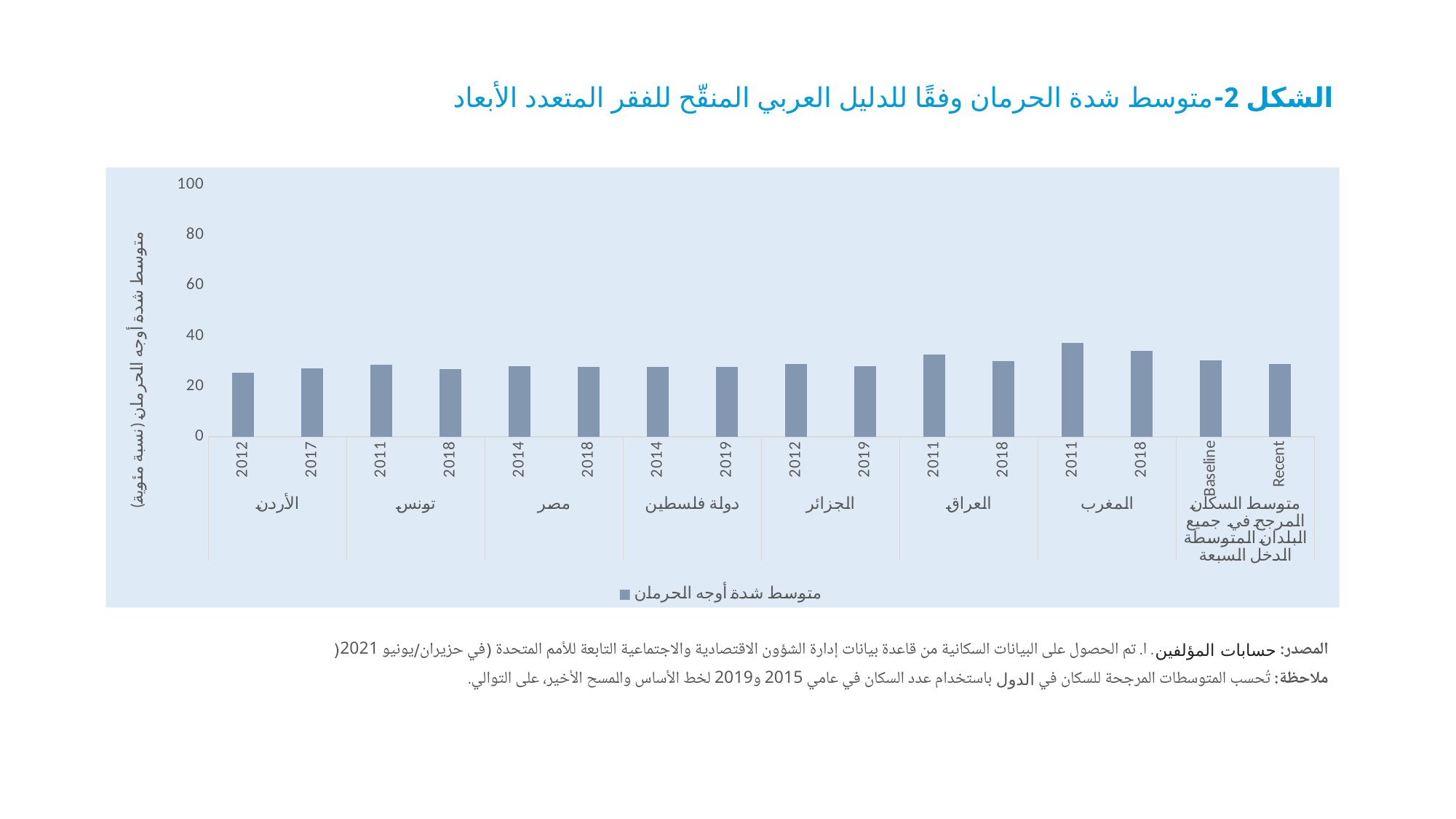
What is the legend entry shown below the chart? متوسط شدة أوجه الحرمان Which is larger, the value for العراق 2011 or the value for الأردن 2012? العراق 2011 Is the value for الأردن 2012 greater or less than 20? greater Is the value for العراق 2011 greater or less than 40? less How many bars are plotted in the chart? 16 How many series does the legend list? 1 Which is larger, the value for المغرب 2011 or the value for المغرب 2018? المغرب 2011 Which bar is the highest in the chart? المغرب 2011 How many country/group categories are shown along the x axis? 8 What kind of chart is shown on the slide? bar chart Is the value for المغرب 2011 greater or less than 40? less For المغرب, does the value rise or fall from 2011 to 2018? fall